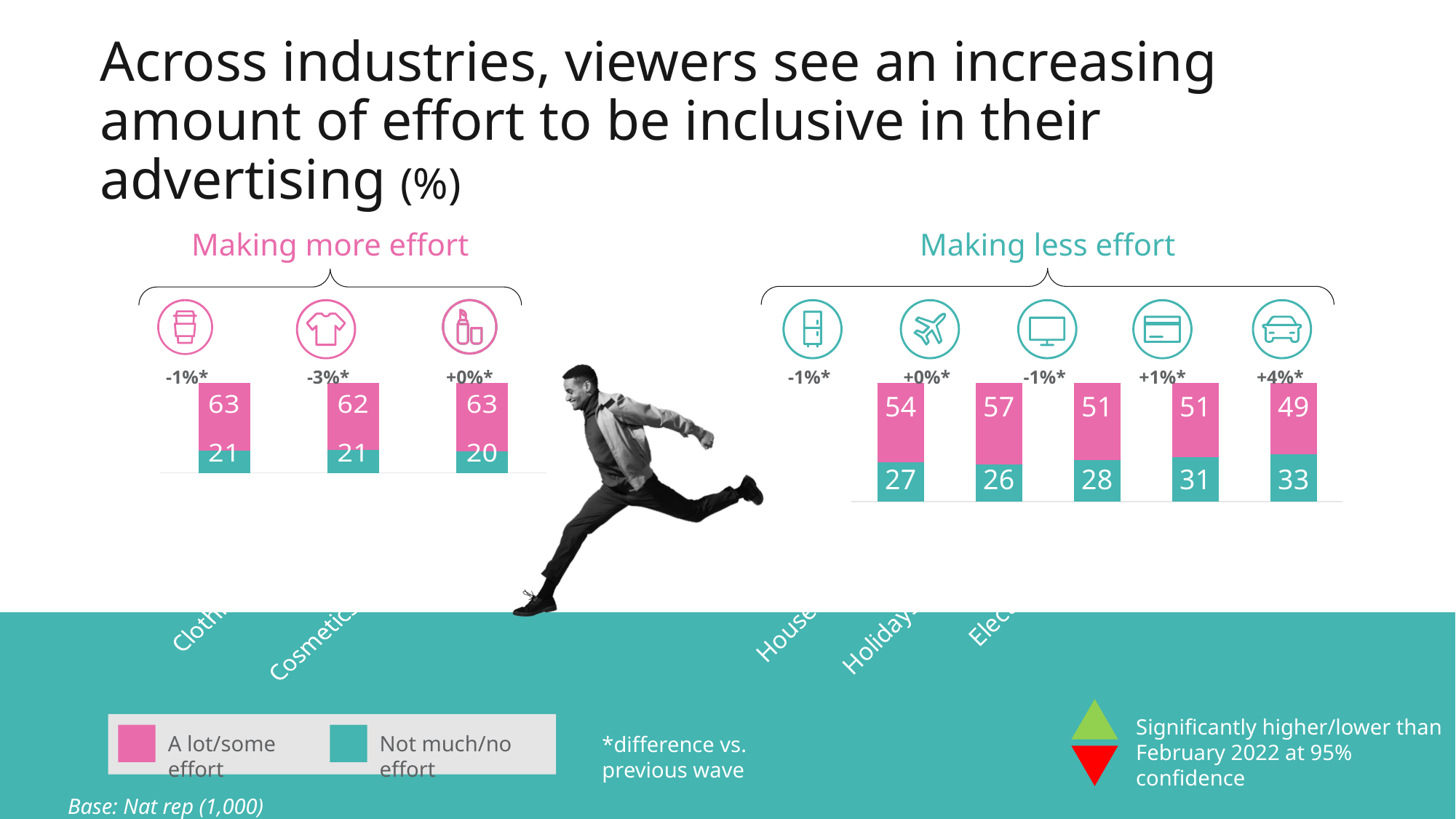
What does the pink colour represent in the legend? A lot/some effort In the 'Making more effort' chart, what is the total of the first stacked bar? 84 In the 'Making less effort' chart, which bar has the highest 'Not much/no effort' value? the fifth bar (33) What kind of chart is used on the slide? stacked bar chart In the 'Making less effort' chart, what is the 'A lot/some effort' value for the first bar? 54 Which is larger: the 'A lot/some effort' value for the second bar in the 'Making more effort' chart or the second bar in the 'Making less effort' chart? the 'Making more effort' chart (62) How many bars are in the 'Making less effort' chart? 5 In the 'Making less effort' chart, which bar has the highest 'A lot/some effort' value? the second bar (57) In the 'Making less effort' chart, what is the difference between the 'A lot/some effort' and 'Not much/no effort' values for the fifth bar? 16 In the 'Making less effort' chart, which bar has the lowest 'A lot/some effort' value? the fifth bar (49) In the 'Making more effort' chart, what is the 'Not much/no effort' value for the third bar? 20 How many series does the legend list? 2